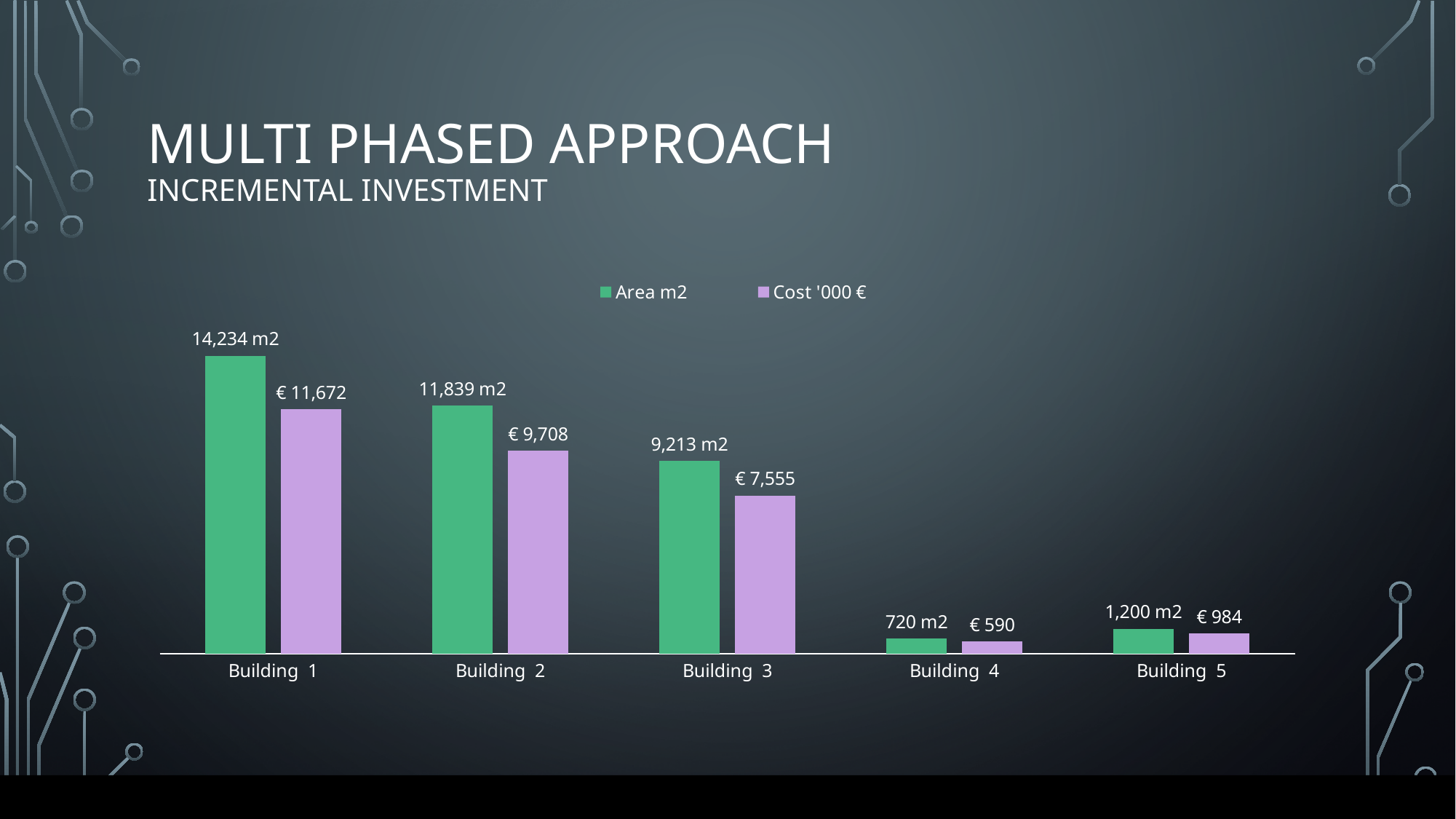
What is the Cost '000 € value for Building 3? € 7,555 Which building has the highest Area m2 value? Building 1 What is the difference between the Cost '000 € values for Building 1 and Building 2? € 1,964 Which building has the lowest Cost '000 € value? Building 4 What is the Area m2 value for Building 4? 720 m2 How many buildings are shown on the x axis? 5 How many series does the legend list? 2 Which is larger, the Area m2 value for Building 5 or for Building 4? Building 5 What is the Area m2 value for Building 1? 14,234 m2 What kind of chart is shown on the slide? Bar chart Which colour represents the Cost '000 € series? Purple What is the Cost '000 € value for Building 5? € 984